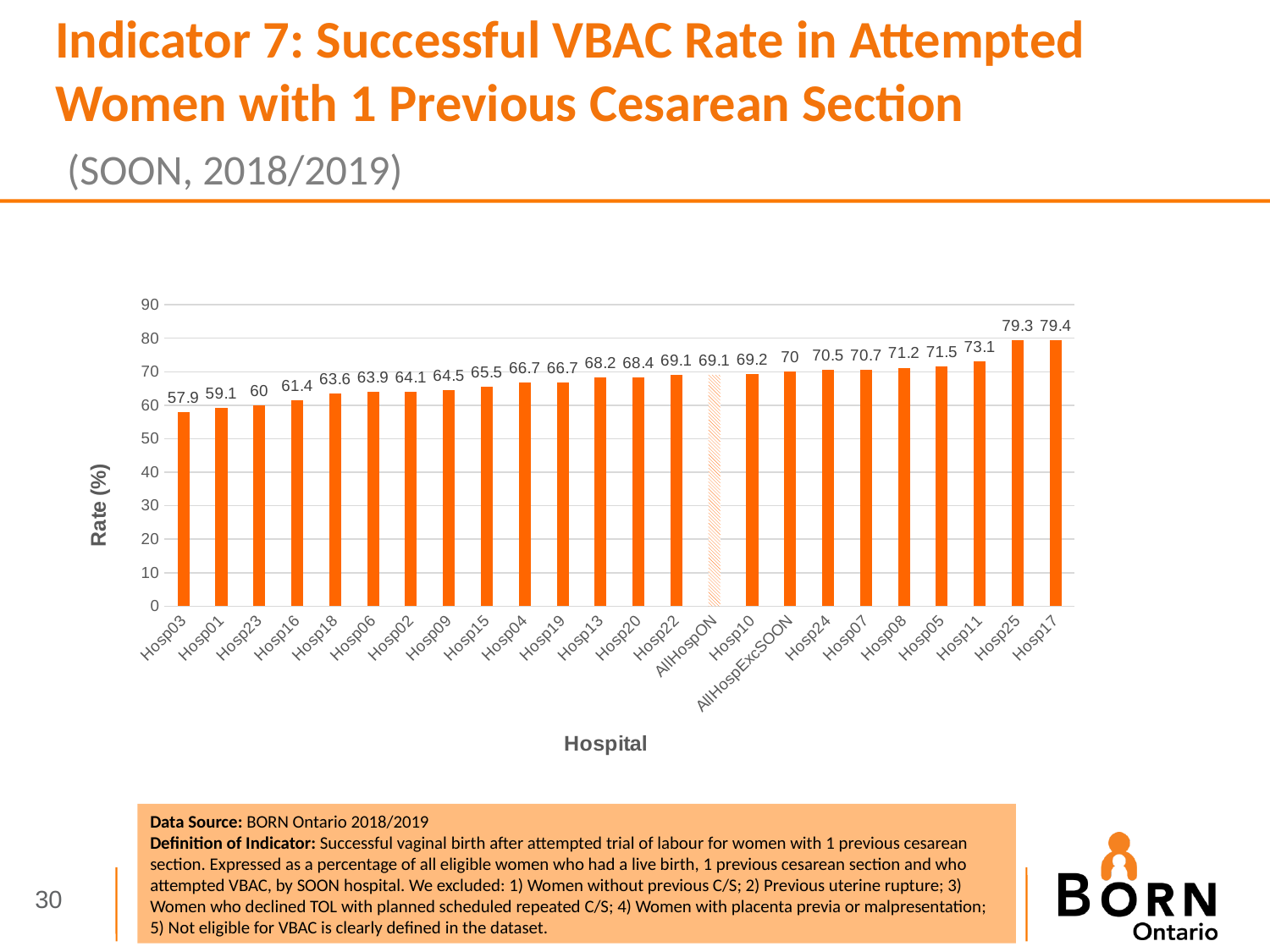
Do the values rise or fall from left to right along the x axis? rise How many hospital categories are shown on the x axis? 24 What is the value for Hosp03? 57.9 What is the difference between the values for Hosp11 and Hosp05? 1.6 What is the value for AllHospExcSOON? 70 What kind of chart is shown on the slide? bar chart What is the value for Hosp11? 73.1 What is the difference between the values for Hosp17 and Hosp03? 21.5 Is the value for Hosp25 greater or less than 70? greater What is the value for AllHospON? 69.1 Which hospital has the lowest rate? Hosp03 Which is larger, the value for Hosp25 or the value for Hosp11? Hosp25